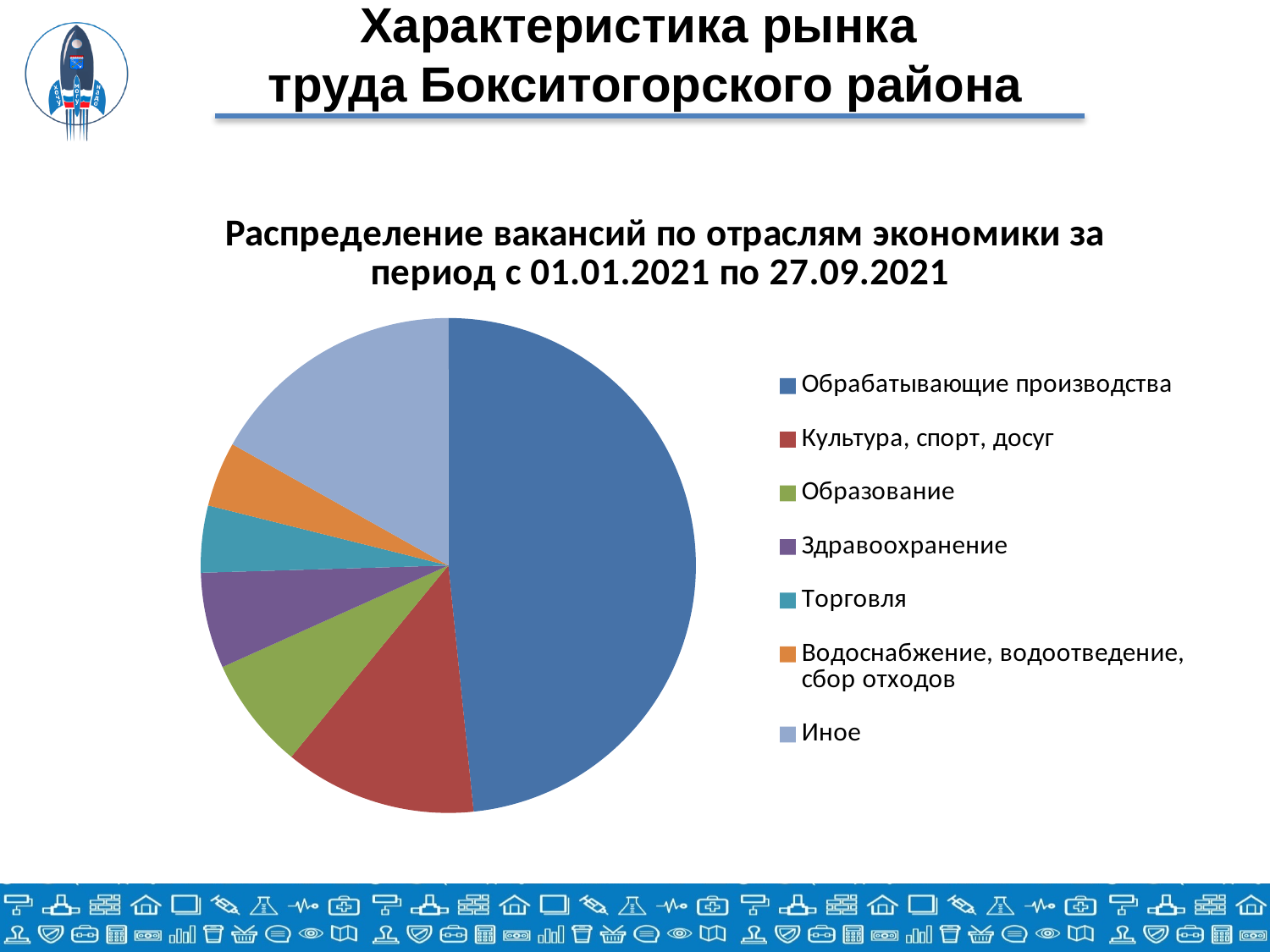
How many entries does the legend of the pie chart list? 7 Which category has the largest slice of the pie chart? Обрабатывающие производства Which slice is larger: Культура, спорт, досуг or Образование? Культура, спорт, досуг Which slice is larger: Иное or Торговля? Иное How many categories (slices) does the pie chart have? 7 Which slice is larger: Обрабатывающие производства or Иное? Обрабатывающие производства What is the title of the pie chart? Распределение вакансий по отраслям экономики за период с 01.01.2021 по 27.09.2021 What kind of chart is shown on the slide? pie chart Which category is shown in orange in the pie chart? Водоснабжение, водоотведение, сбор отходов